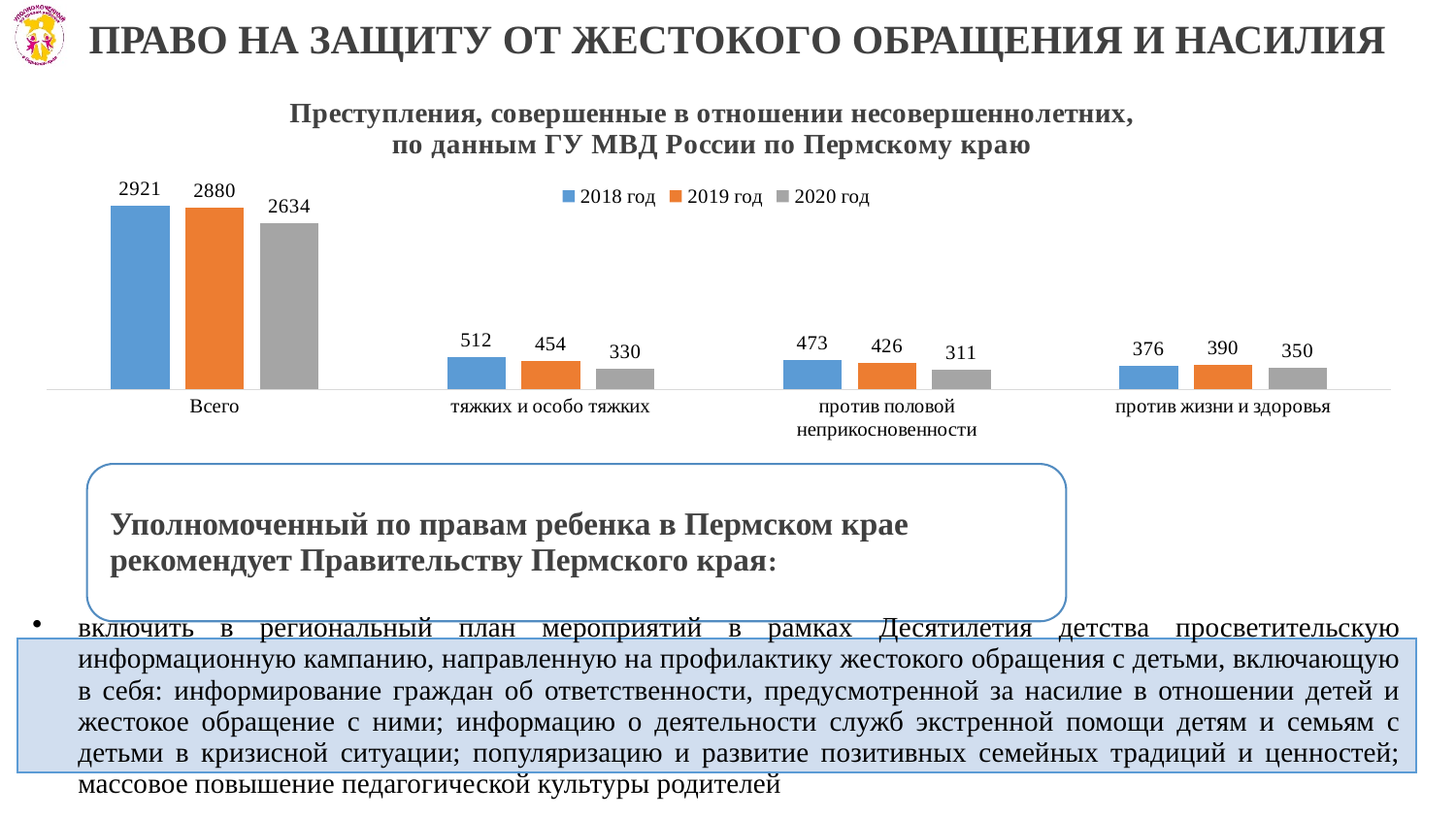
Which category has the lowest value in the 2020 год series? против половой неприкосновенности What kind of chart is shown on the slide? Bar chart What is the value for "Всего" in the 2018 год series? 2921 What is the value for "против жизни и здоровья" in the 2019 год series? 390 What is the value for "тяжких и особо тяжких" in the 2020 год series? 330 What is the value for "против половой неприкосновенности" in the 2019 год series? 426 What is the difference between the 2018 год and 2020 год values for "Всего"? 287 Which category has the highest value in the 2018 год series? Всего For "против жизни и здоровья", which is larger: the 2018 год value or the 2019 год value? 2019 год How many series does the legend list? 3 How many categories are shown on the x axis of the chart? 4 What is the difference between the 2018 год and 2019 год values for "тяжких и особо тяжких"? 58